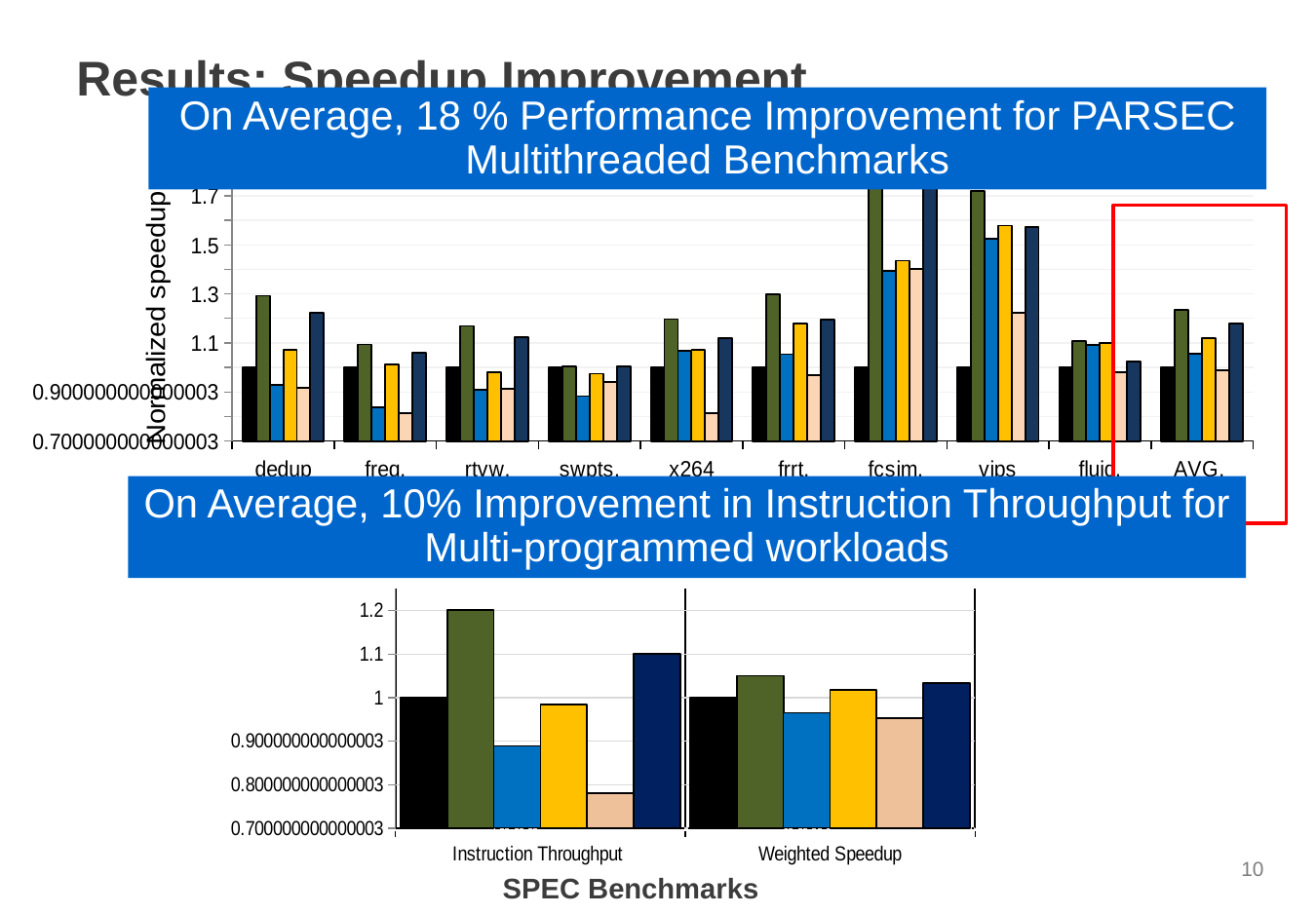
What is the y-axis label of the top chart? Normalized speedup What kind of chart is the top chart on the slide? bar chart In the bottom chart, what is the value of the black bar for Instruction Throughput? 1 In the top chart, which category contains the tallest bars? fcsim. In the top chart, which is larger: the dark green bar for vips or the dark green bar for fluid.? vips How many categories are shown on the x axis of the bottom chart? 2 How many benchmark categories are shown along the x axis of the top chart? 10 What is the x-axis title of the bottom chart? SPEC Benchmarks In the bottom chart, which bar is the lowest for Instruction Throughput? the peach bar In the top chart, is the dark green bar for AVG. greater or less than 1.1? greater In the top chart, is the peach bar for freq. greater or less than 0.9? less In the top chart, is the dark green bar for dedup greater or less than 1.1? greater